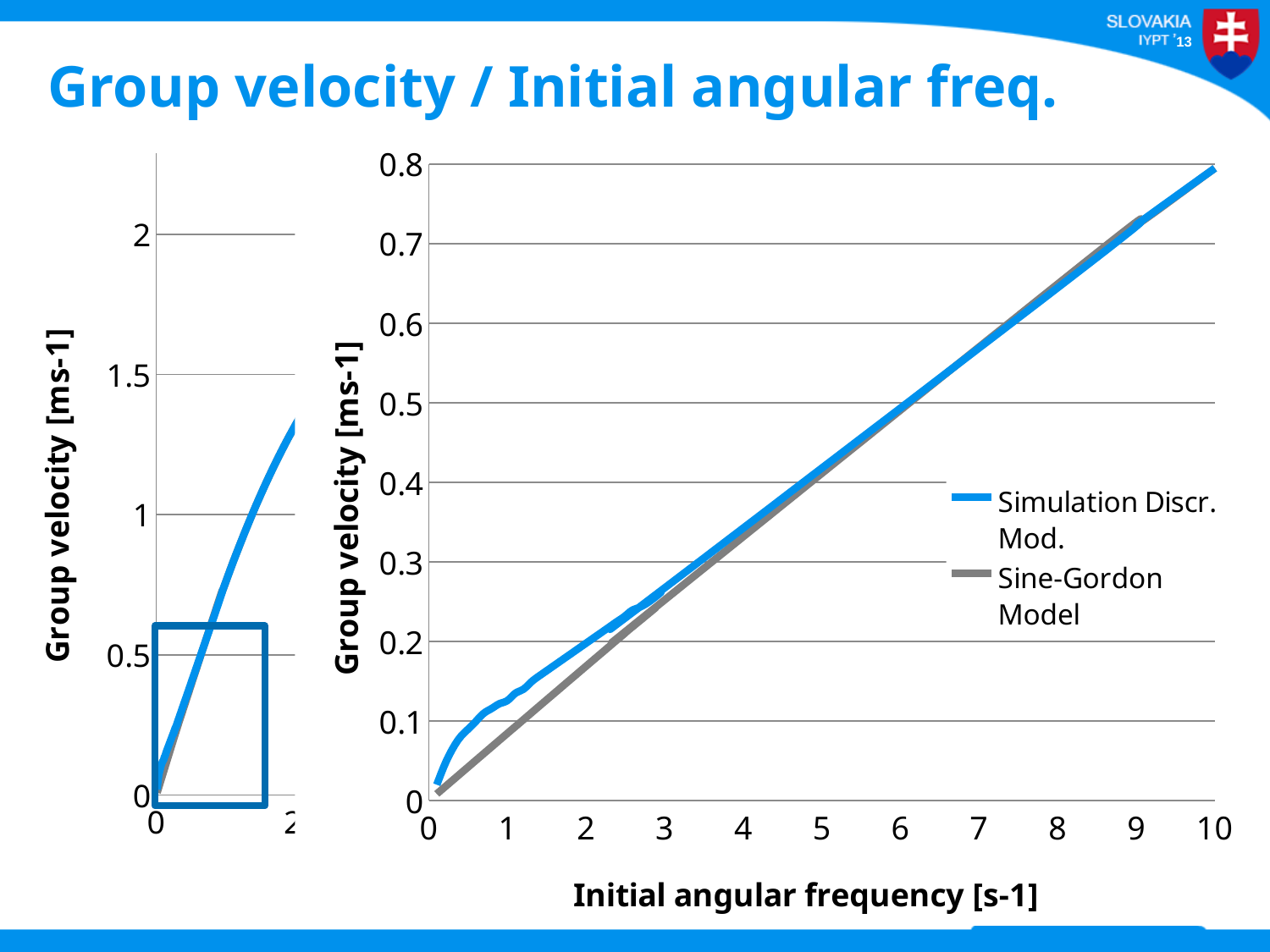
In the small chart on the left, what kind of chart is it? line chart In the large chart on the right, at initial angular frequency 1, which series has the higher group velocity: Simulation Discr. Mod. or Sine-Gordon Model? Simulation Discr. Mod. In the large chart on the right, what are the two series named in the legend? Simulation Discr. Mod. and Sine-Gordon Model In the large chart on the right, what kind of chart is it? line chart In the large chart on the right, how many series does the legend list? 2 In the large chart on the right, does the Simulation Discr. Mod. line rise or fall as initial angular frequency increases? rise In the large chart on the right, is the Sine-Gordon Model value at initial angular frequency 8 greater or less than 0.6? greater In the large chart on the right, is the Simulation Discr. Mod. value at initial angular frequency 10 greater or less than 0.7? greater In the large chart on the right, does the Sine-Gordon Model line rise or fall along the x axis? rise In the large chart on the right, what is the title of the x axis? Initial angular frequency [s-1] In the large chart on the right, is the Sine-Gordon Model value at initial angular frequency 5 greater or less than 0.5? less